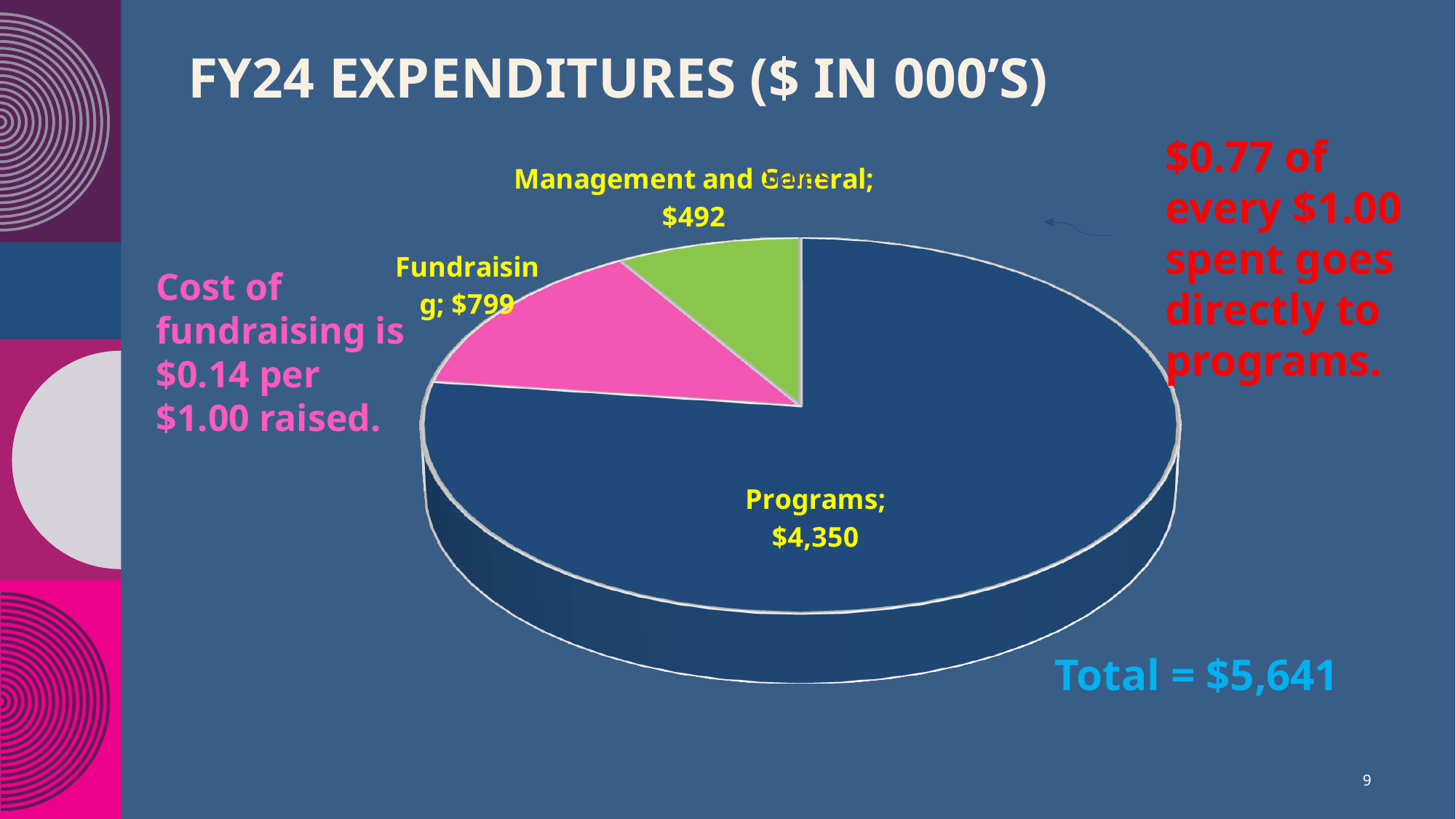
What is the value of the Programs slice in the pie chart? $4,350 What is the difference between the Programs value and the Fundraising value? $3,551 How many slices does the pie chart have? 3 What is the difference between the Fundraising value and the Management and General value? $307 Which is larger, Fundraising or Management and General? Fundraising What type of chart is shown on the slide? Pie chart What is the title of the slide containing the pie chart? FY24 EXPENDITURES ($ IN 000'S) What is the value of the Fundraising slice in the pie chart? $799 Which category has the largest slice in the pie chart? Programs What is the total of all slices in the pie chart? $5,641 What is the value of the Management and General slice in the pie chart? $492 Which category has the smallest slice in the pie chart? Management and General